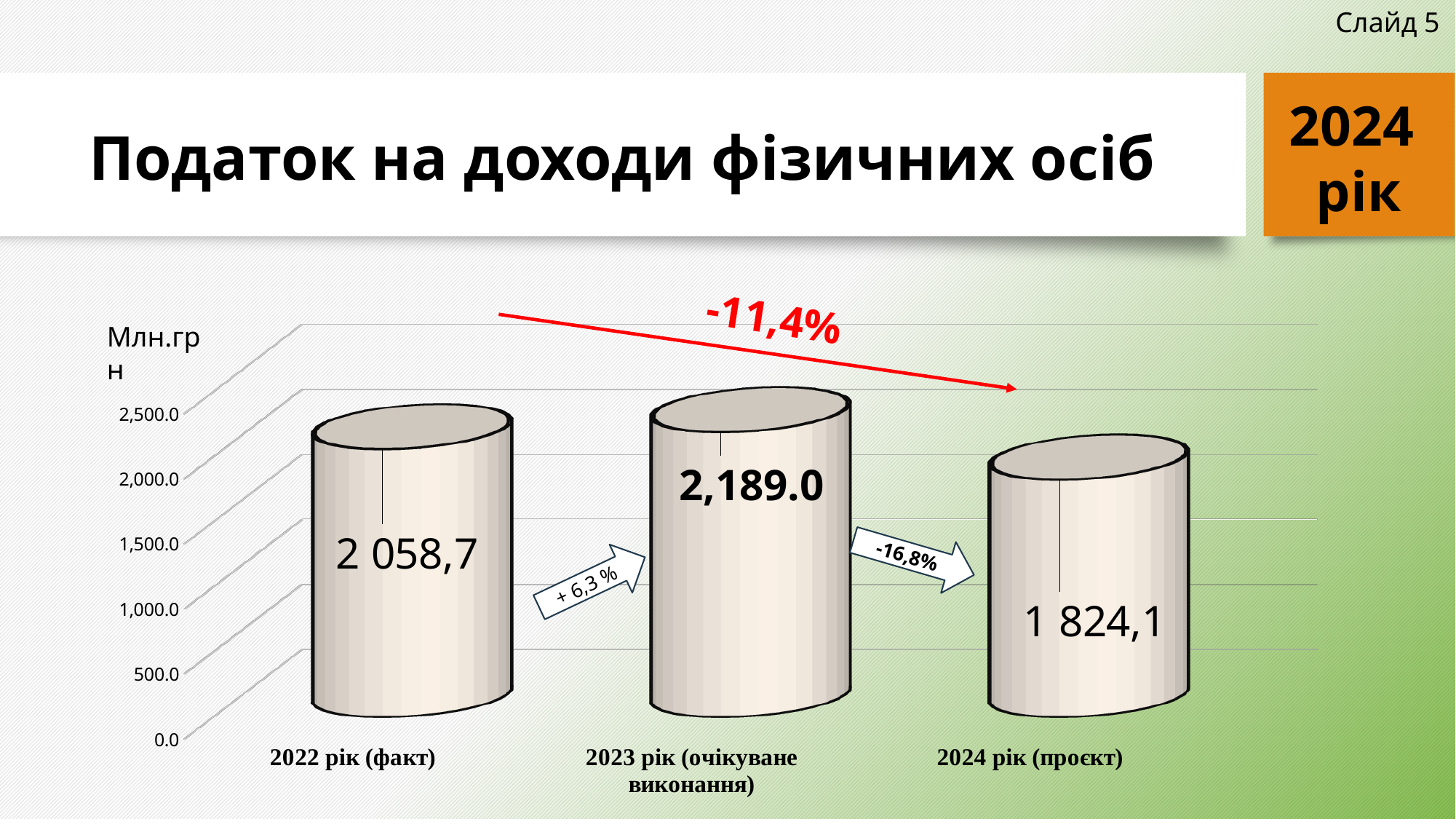
What kind of chart is shown on the slide? bar chart Is the value for 2024 рік (проєкт) greater or less than 2,000.0? less What unit is shown on the vertical axis of the chart? Млн.грн What is the value for 2024 рік (проєкт)? 1 824,1 Which category has the highest value? 2023 рік (очікуване виконання) What percentage change is shown by the arrow between 2023 рік and 2024 рік? -16,8% What is the value for 2023 рік (очікуване виконання)? 2,189.0 How many categories are shown on the chart? 3 Which is larger, the value for 2022 рік (факт) or the value for 2024 рік (проєкт)? 2022 рік (факт) Which category has the lowest value? 2024 рік (проєкт) What is the value for 2022 рік (факт)? 2 058,7 Is the value for 2023 рік (очікуване виконання) greater or less than 2,000.0? greater